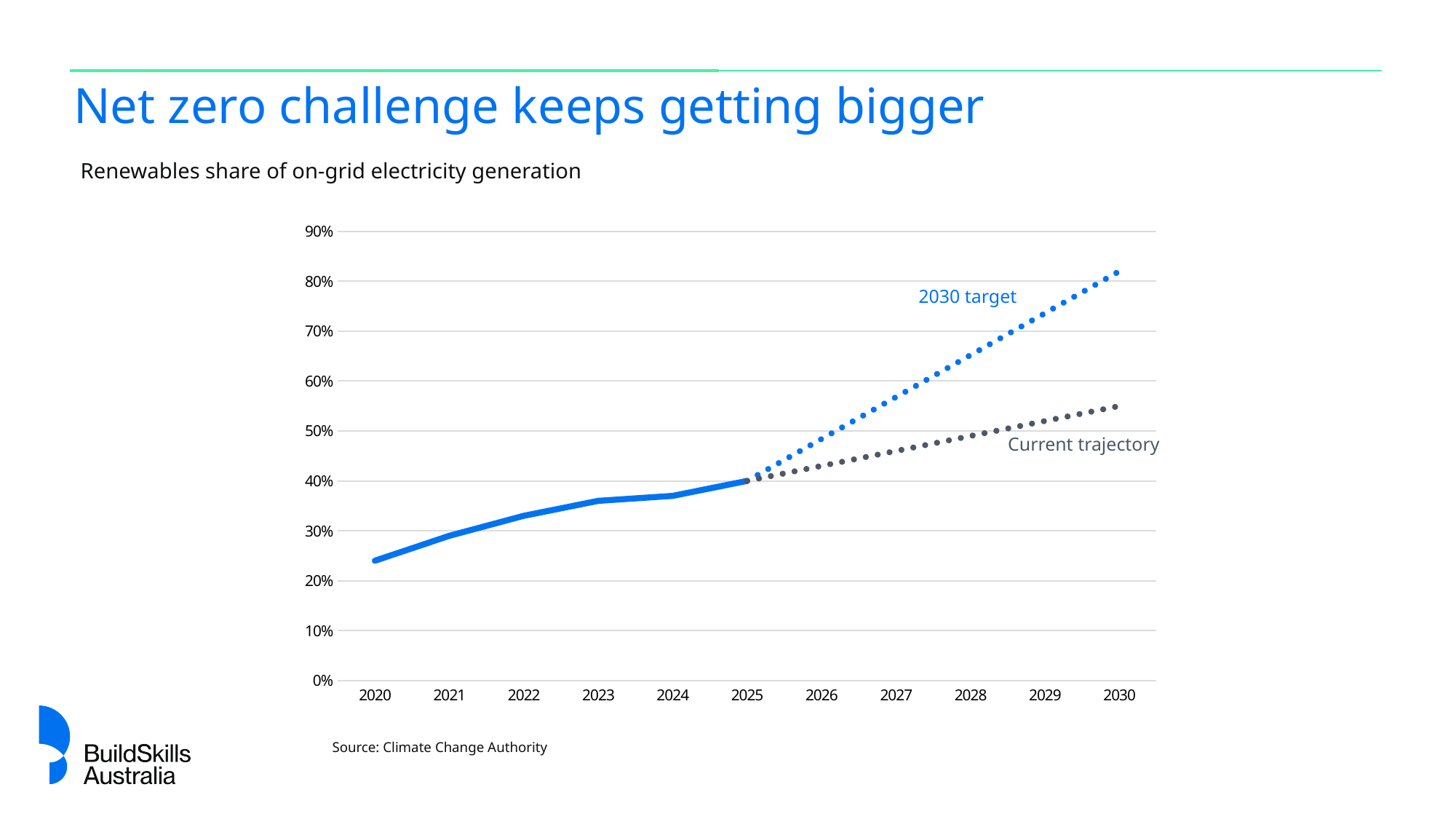
Which year has the highest value on the solid line? 2025 Is the renewables share in 2023 greater or less than 40%? less How many years are labelled on the x axis? 11 What kind of chart is shown on the slide? line chart Is the renewables share in 2020 greater or less than 30%? less In 2030, which is higher: the 2030 target line or the Current trajectory line? 2030 target Is the 2030 target value greater or less than 70%? greater Does the renewables share rise or fall from 2020 to 2025? rises What is the source cited below the chart? Climate Change Authority What does the chart measure, according to the text above it? Renewables share of on-grid electricity generation